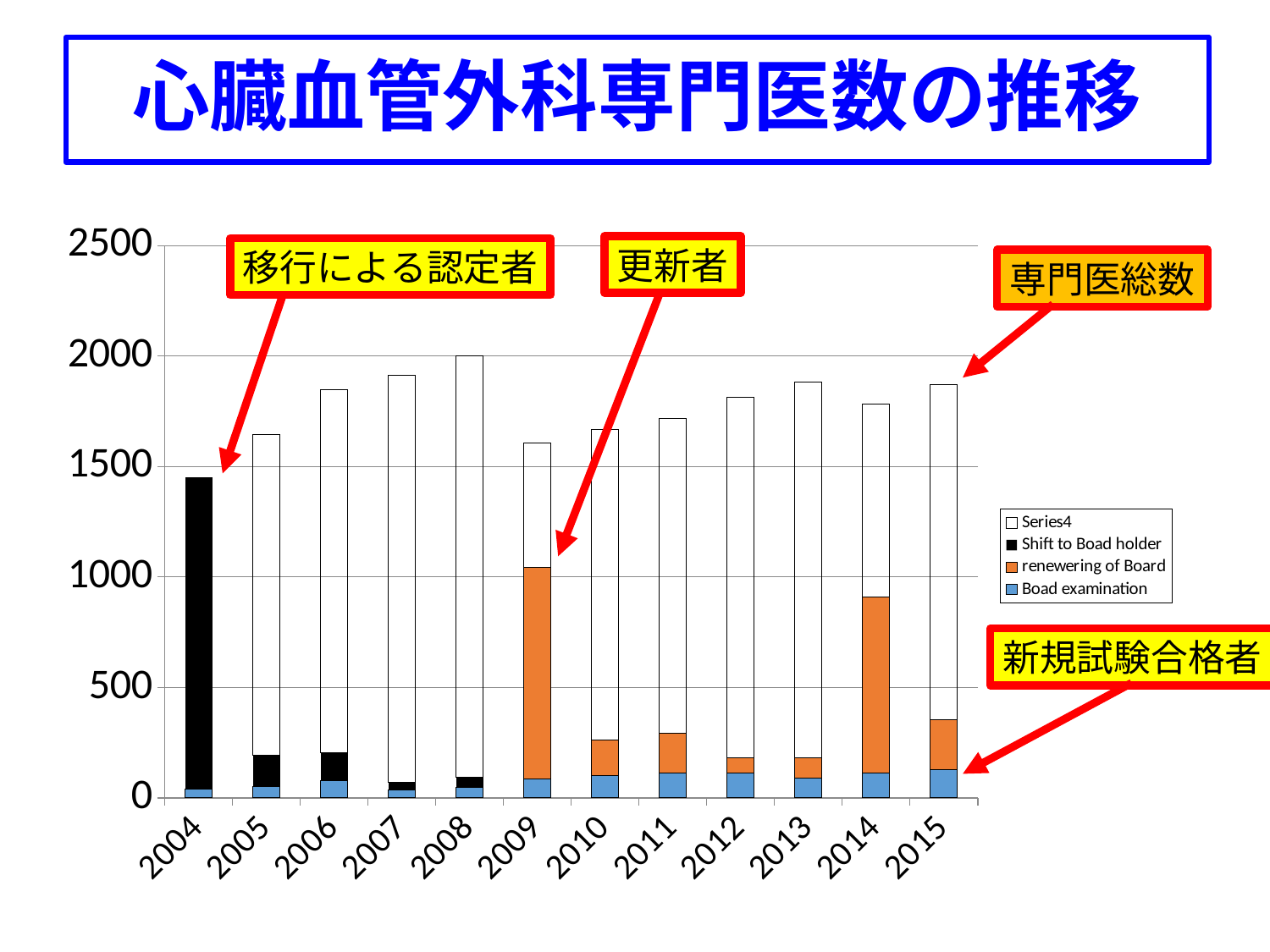
Do the total bar heights rise or fall from 2004 to 2008? rise What colour represents 'Boad examination' in the chart? blue What kind of chart is shown on the slide? stacked bar chart Is the 'renewering of Board' segment larger in 2009 or in 2014? 2009 Which year has the highest total bar height in the chart? 2008 Which legend entry is shown in black? Shift to Boad holder How many years are shown on the x axis of the chart? 12 Is the total bar height for 2010 greater or less than 1500? greater Is the total bar height for 2015 greater or less than 2000? less Which year has the lowest total bar height in the chart? 2004 Is the total bar height for 2004 greater or less than 1000? greater How many series does the chart's legend list? 4